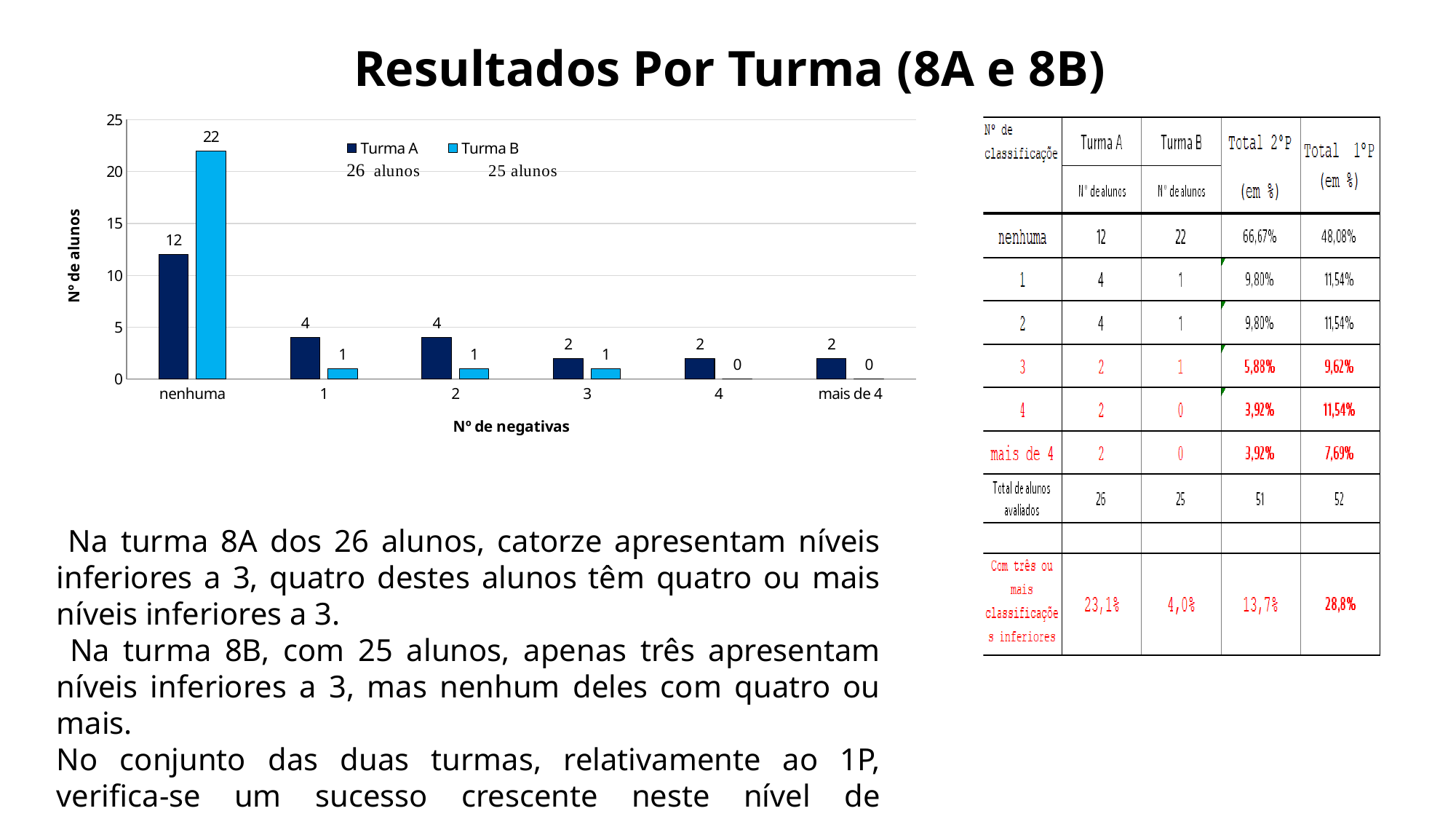
Which is larger in the '1' category, Turma A or Turma B? Turma A How many series does the chart legend list? 2 What is the label of the x axis of the chart? Nº de negativas What type of chart is shown on the slide? bar chart What is the difference between Turma B and Turma A in the 'nenhuma' category? 10 Which category has the highest value for Turma B? nenhuma What is the value for Turma B in the 'mais de 4' category? 0 How many categories are shown on the x axis of the chart? 6 What is the value for Turma A in the '2' category? 4 What is the value for Turma A in the 'nenhuma' category? 12 What is the value for Turma B in the 'nenhuma' category? 22 Is the value for Turma B in the 'nenhuma' category greater or less than 20? greater